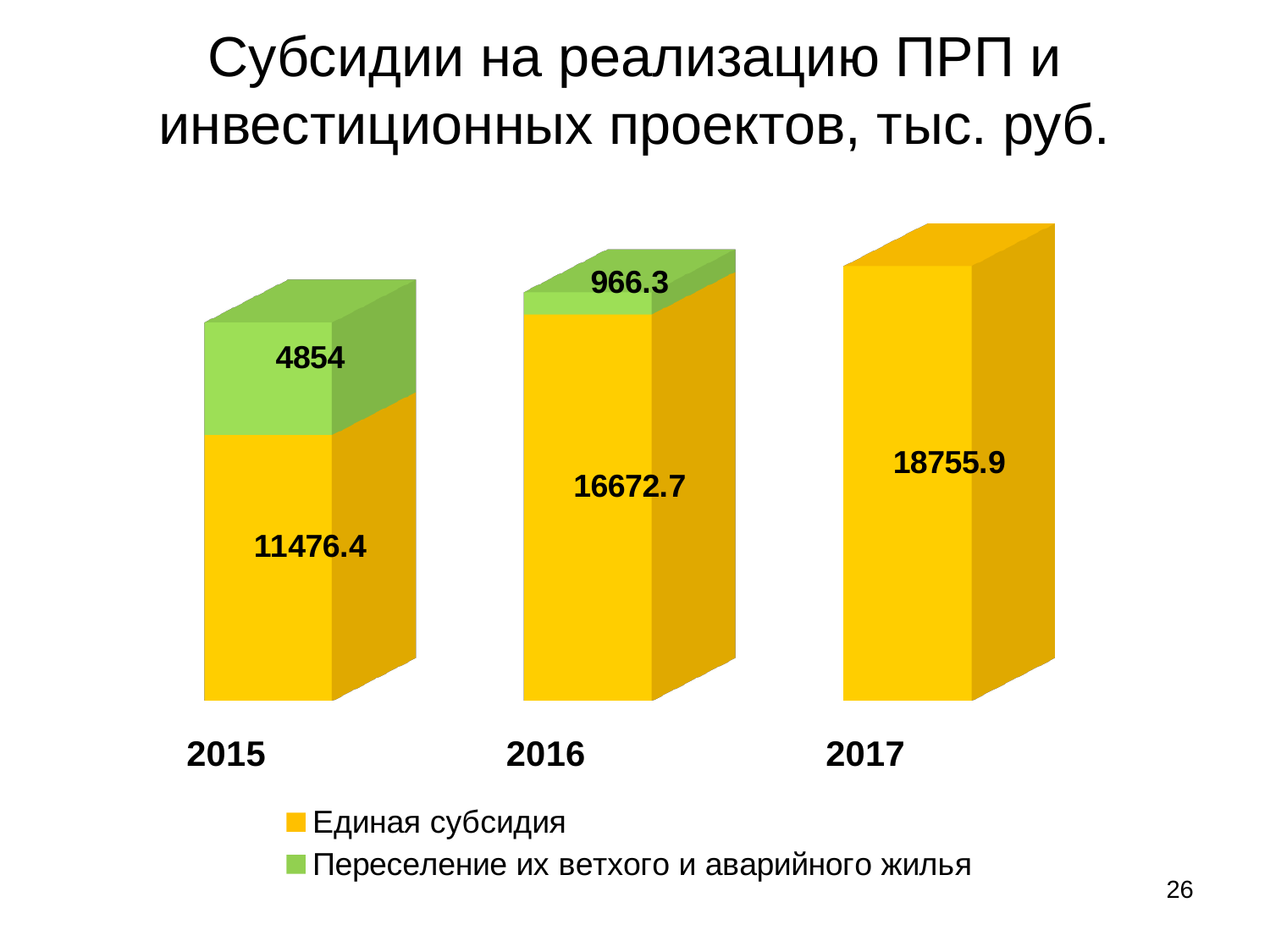
What is the difference between the Единая субсидия values for 2017 and 2016? 2083.2 What is the value of Единая субсидия for 2015? 11476.4 Which year has the highest value for Единая субсидия? 2017 Which is larger: Единая субсидия in 2016 or in 2015? 2016 How many years are shown on the x axis? 3 What is the value of Переселение их ветхого и аварийного жилья for 2015? 4854 What is the value of Единая субсидия for 2017? 18755.9 How many series does the legend list? 2 What is the difference between the Переселение их ветхого и аварийного жилья values for 2015 and 2016? 3887.7 What is the value of Переселение их ветхого и аварийного жилья for 2016? 966.3 What is the total of the stacked bar for 2015? 16330.4 Which year has the lowest value for Единая субсидия? 2015